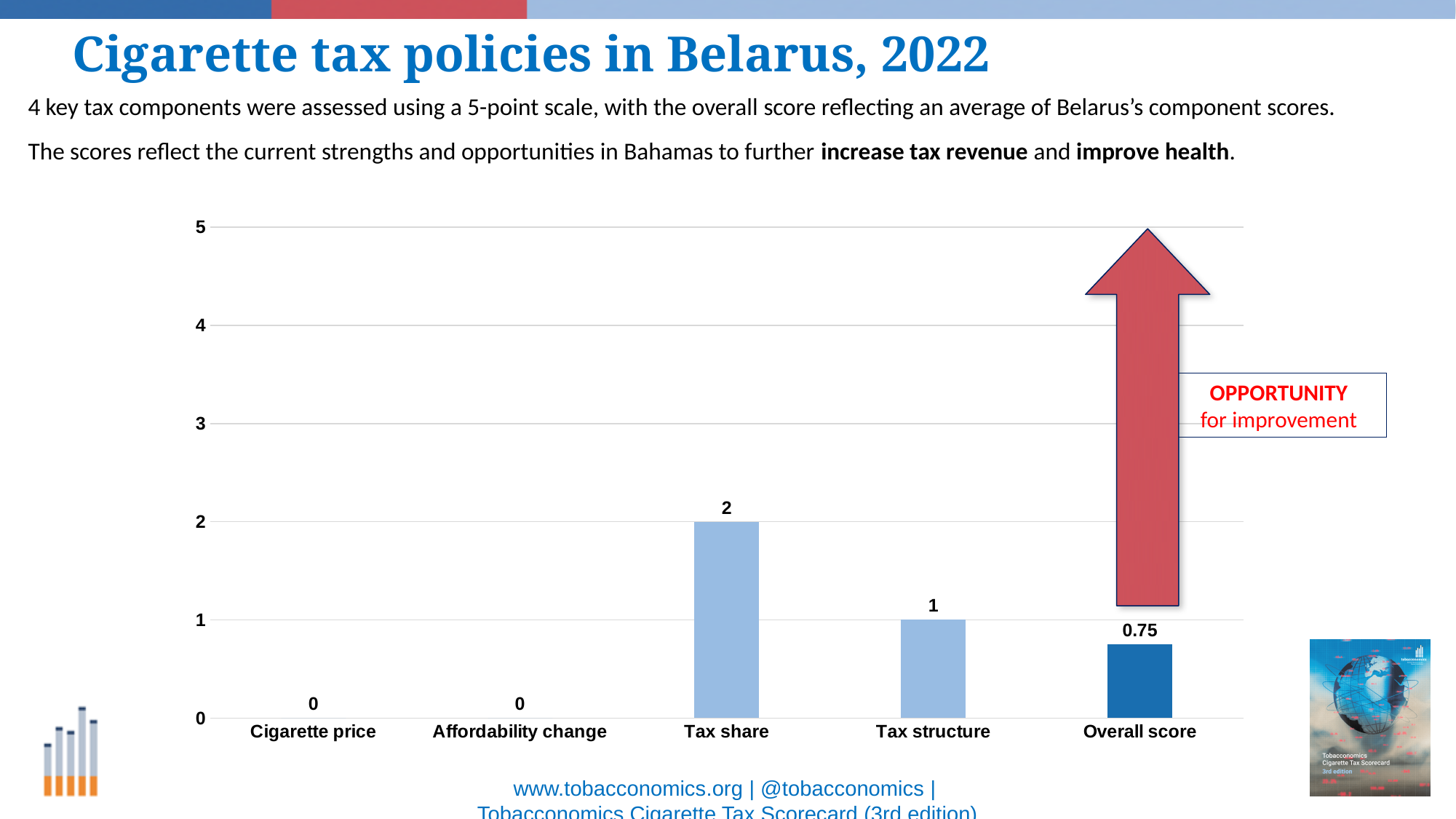
Is the value for Tax share greater or less than 1? greater What is the value for Tax share? 2 What is the maximum value shown on the y axis? 5 What is the value for Tax structure? 1 What is the Overall score? 0.75 How many categories are shown on the x axis? 5 Which category has the highest value? Tax share What kind of chart is shown on the slide? bar chart What is the value for Affordability change? 0 What is the difference between the values for Tax share and Tax structure? 1 Which is larger, the value for Tax structure or the Overall score? Tax structure What is the value for Cigarette price? 0